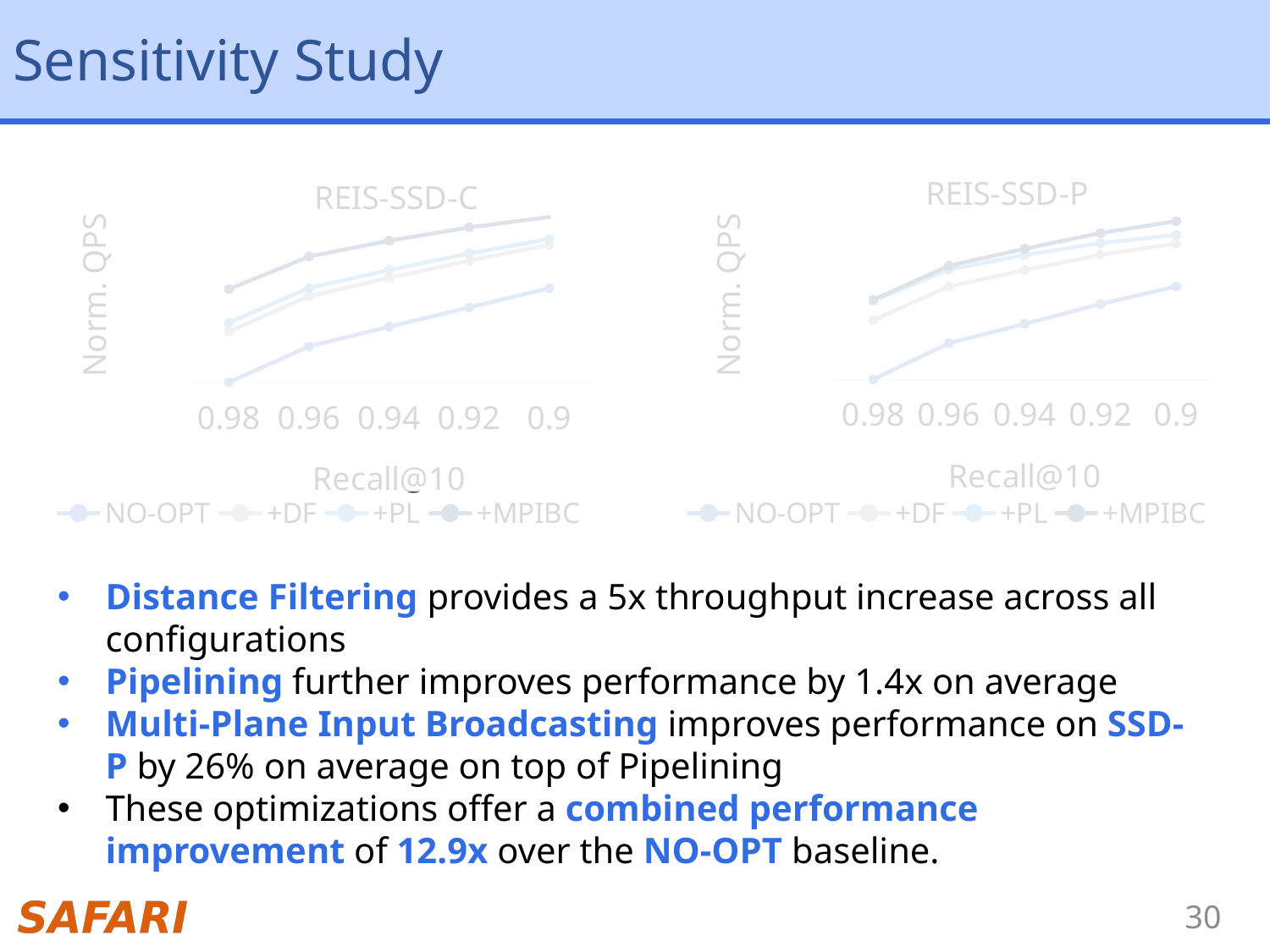
How many Recall@10 values are shown on the x axis of the REIS-SSD-C chart? 5 In the REIS-SSD-C chart, which series has the lowest Norm. QPS across all Recall@10 values? NO-OPT How many data points does each series have in the REIS-SSD-P chart? 5 What kind of chart is the REIS-SSD-C chart? line chart In the REIS-SSD-P chart, does the +MPIBC series rise or fall as Recall@10 goes from 0.98 to 0.9? rise What is the label of the y axis on the REIS-SSD-P chart? Norm. QPS How many series does the legend of the REIS-SSD-P chart list? 4 What kind of chart is the REIS-SSD-P chart? line chart In the REIS-SSD-C chart, which series has the highest Norm. QPS at Recall@10 = 0.9? +MPIBC How many series does the legend of the REIS-SSD-C chart list? 4 In the REIS-SSD-P chart, which series has a higher Norm. QPS at Recall@10 = 0.94, NO-OPT or +DF? +DF In the REIS-SSD-C chart, does the NO-OPT series rise or fall as Recall@10 goes from 0.98 to 0.9? rise